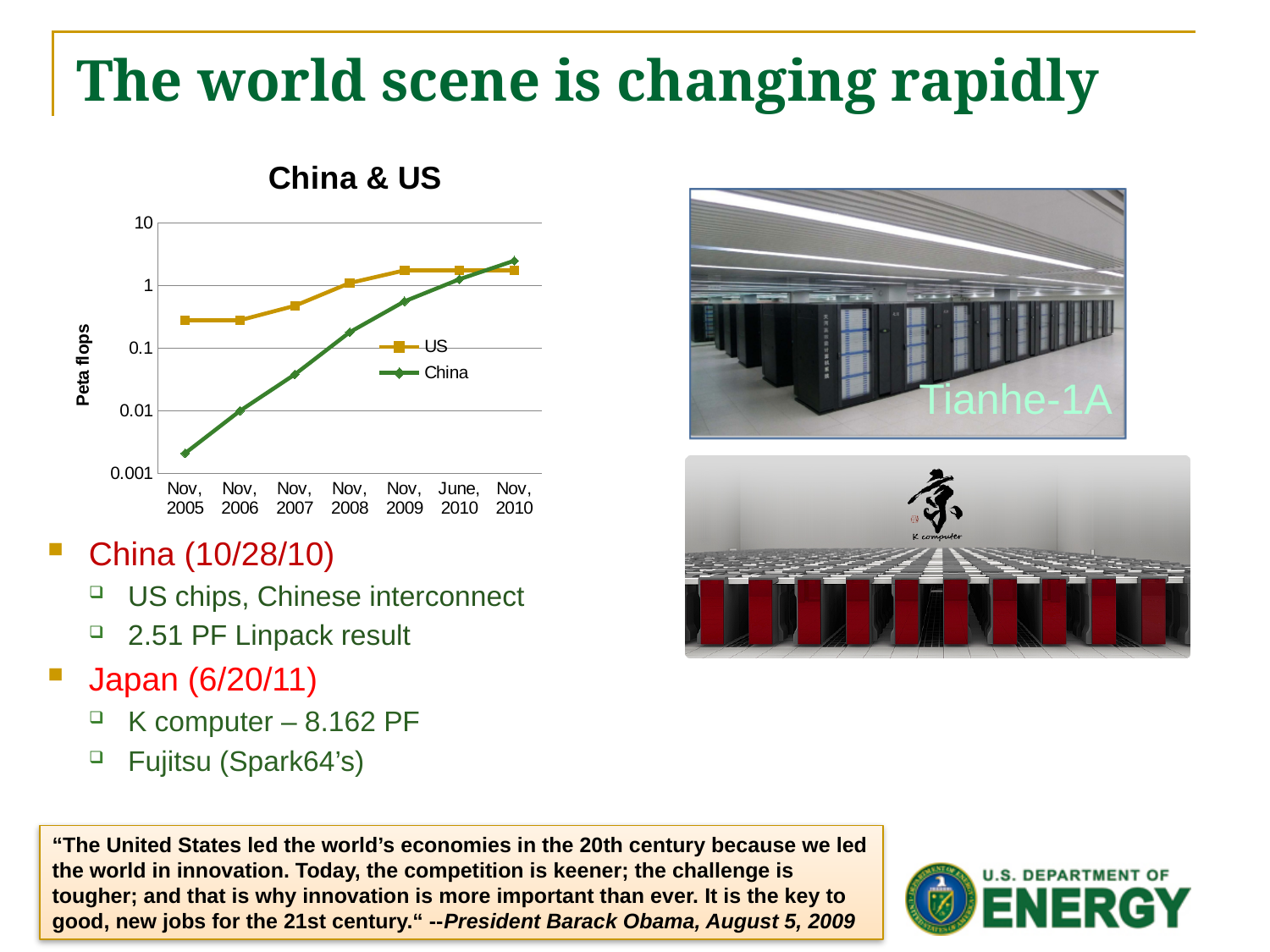
In the "China & US" chart, is the value for China in Nov 2010 greater or less than 1? greater In the "China & US" chart, which series is drawn in green? China What is the y-axis label of the "China & US" chart? Peta flops What kind of chart is the "China & US" chart? line chart In the "China & US" chart, is the value for US in Nov 2009 greater or less than 1? greater In the "China & US" chart, which series has the higher value in Nov 2005, US or China? US In the "China & US" chart, is the value for US in Nov 2005 greater or less than 1? less In the "China & US" chart, does the China series rise or fall from Nov 2005 to Nov 2010? rise How many series does the legend of the "China & US" chart list? 2 How many time points are shown on the x axis of the "China & US" chart? 7 In the "China & US" chart, which series has the higher value in Nov 2010, US or China? China